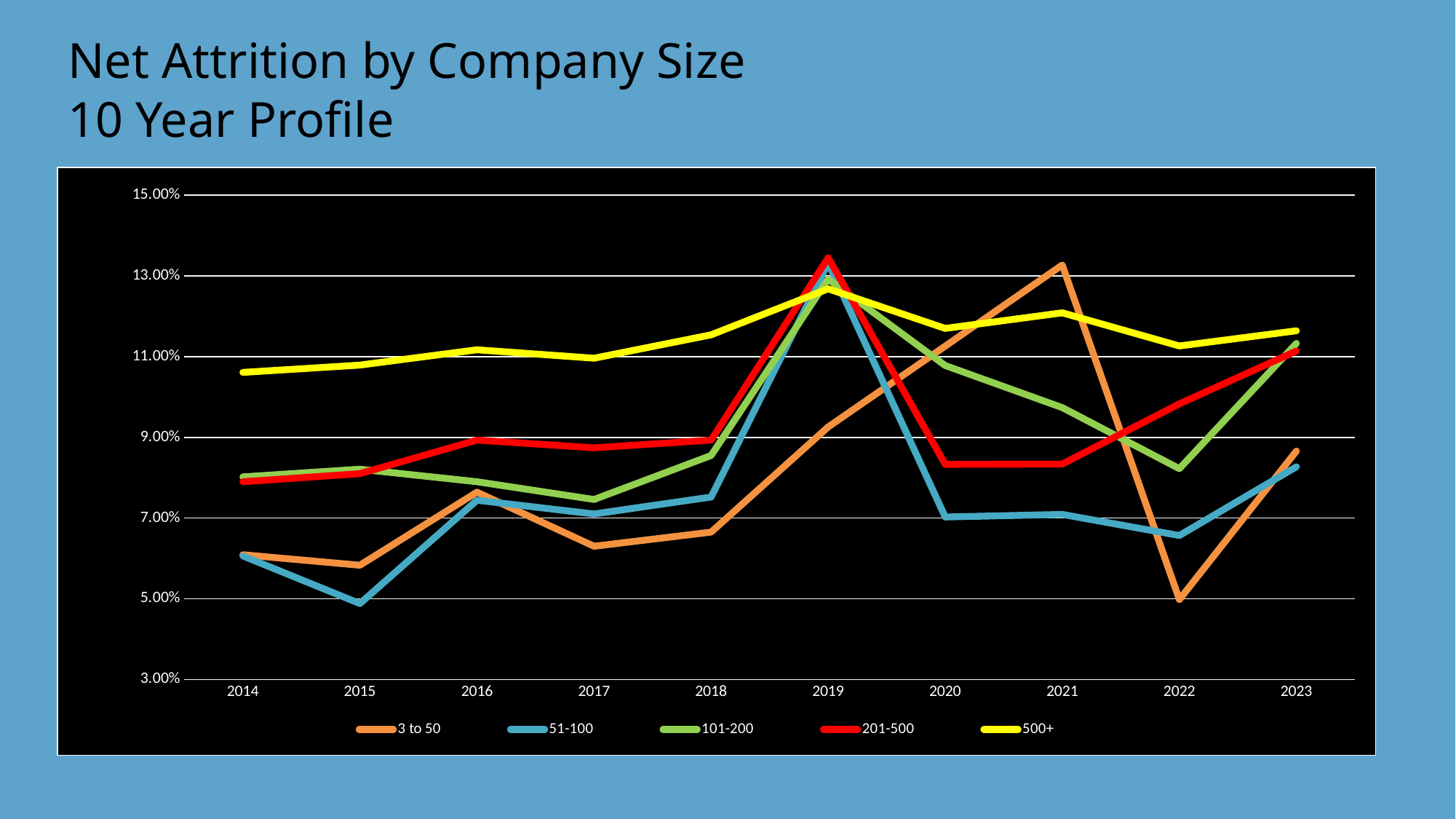
Is the value for 500+ in 2014 greater or less than 11.00%? less How many series does the legend list? 5 In which year does the 201-500 series reach its highest value? 2019 What kind of chart is shown on the slide? line chart In which year does the 3 to 50 series reach its highest value? 2021 Is the value for 51-100 in 2015 greater or less than 7.00%? less What colour is the line for the 500+ series? yellow Which company size has the highest net attrition in 2014? 500+ In 2021, which is larger: the value for 3 to 50 or the value for 51-100? 3 to 50 Is the value for 201-500 in 2019 greater or less than 13.00%? greater How many years are shown along the x axis? 10 Which company size has the lowest net attrition in 2015? 51-100